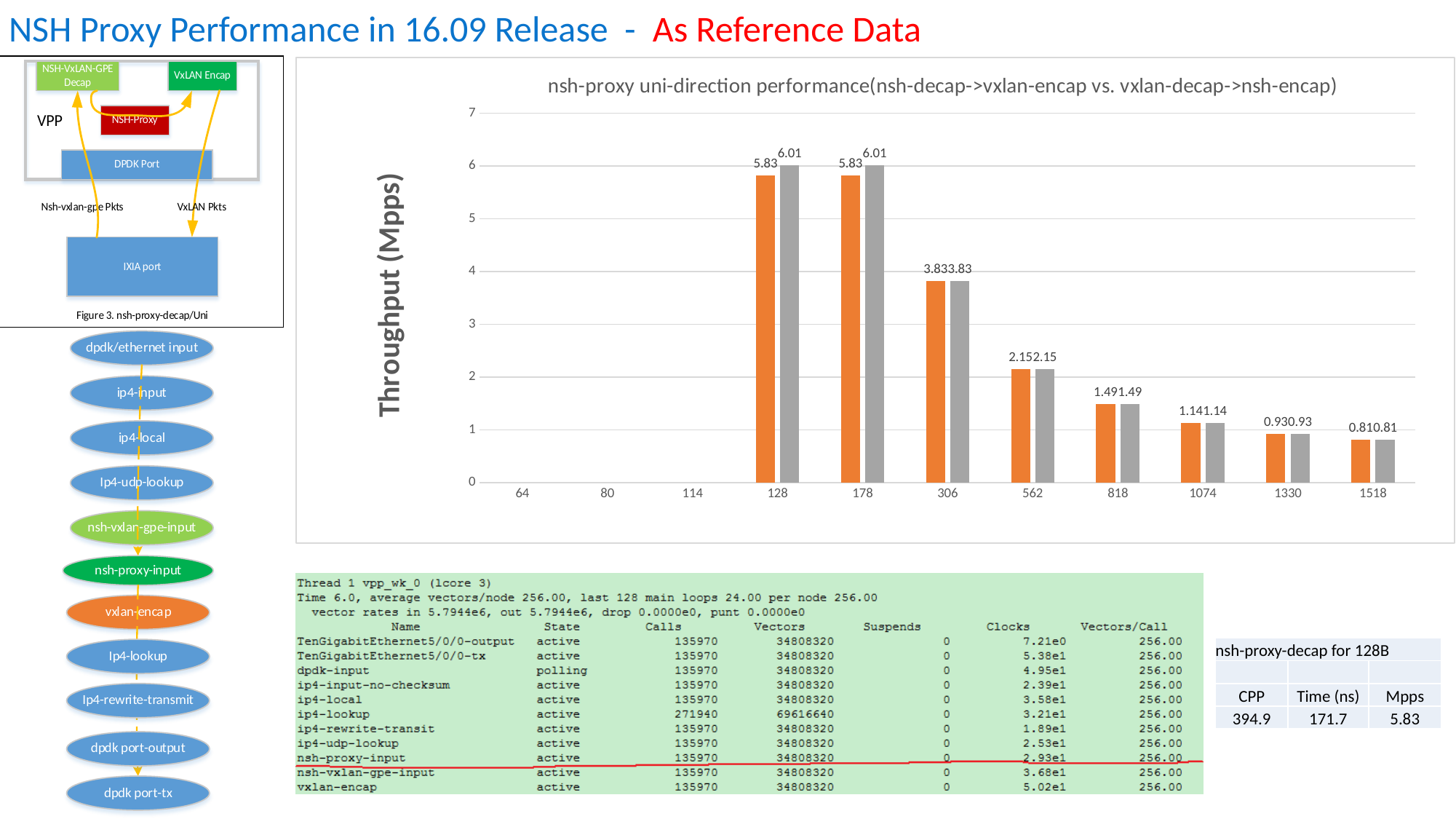
Do the bar values rise or fall along the x axis from 128 to 1518? fall For category 178, which bar is larger, the orange or the gray? gray Which category has the lowest orange bar? 1518 What is the value of the orange bar for category 306? 3.83 What kind of chart is shown on the slide? bar chart What is the value of the orange bar for category 128? 5.83 What is the difference between the gray bar and the orange bar for category 128? 0.18 What is the value of the gray bar for category 1518? 0.81 What is the value of the gray bar for category 128? 6.01 What is the y-axis title of the chart? Throughput (Mpps) How many categories are shown on the x axis? 11 What is the value of the orange bar for category 818? 1.49